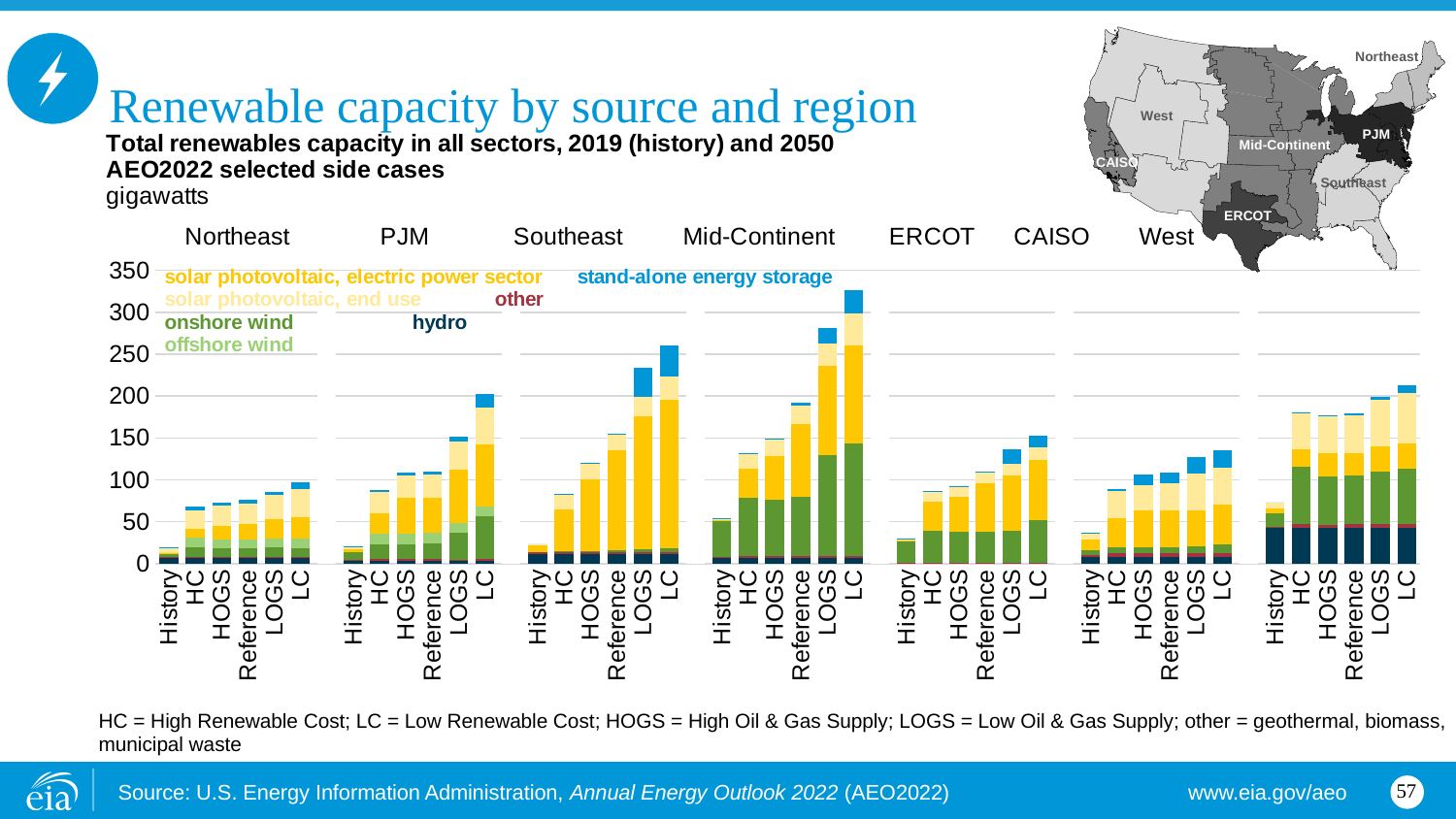
Which region and case has the tallest bar on the chart? Mid-Continent, LC What unit is the y axis measured in? gigawatts How many cases (bars) are shown for each region? 6 Which is larger, the LC total for Mid-Continent or the LC total for West? Mid-Continent How many series does the chart's legend list? 7 In the Northeast panel, which case has the highest total renewable capacity? LC What kind of chart is shown on the slide? stacked bar chart In the ERCOT panel, which case has the lowest total renewable capacity? History How many regions (panels) does the chart show? 7 Is the total for the Northeast History case greater or less than 50? less Is the total for the Mid-Continent LC case greater or less than 300? greater In the Mid-Continent panel, do the totals rise or fall moving from History to LC? rise